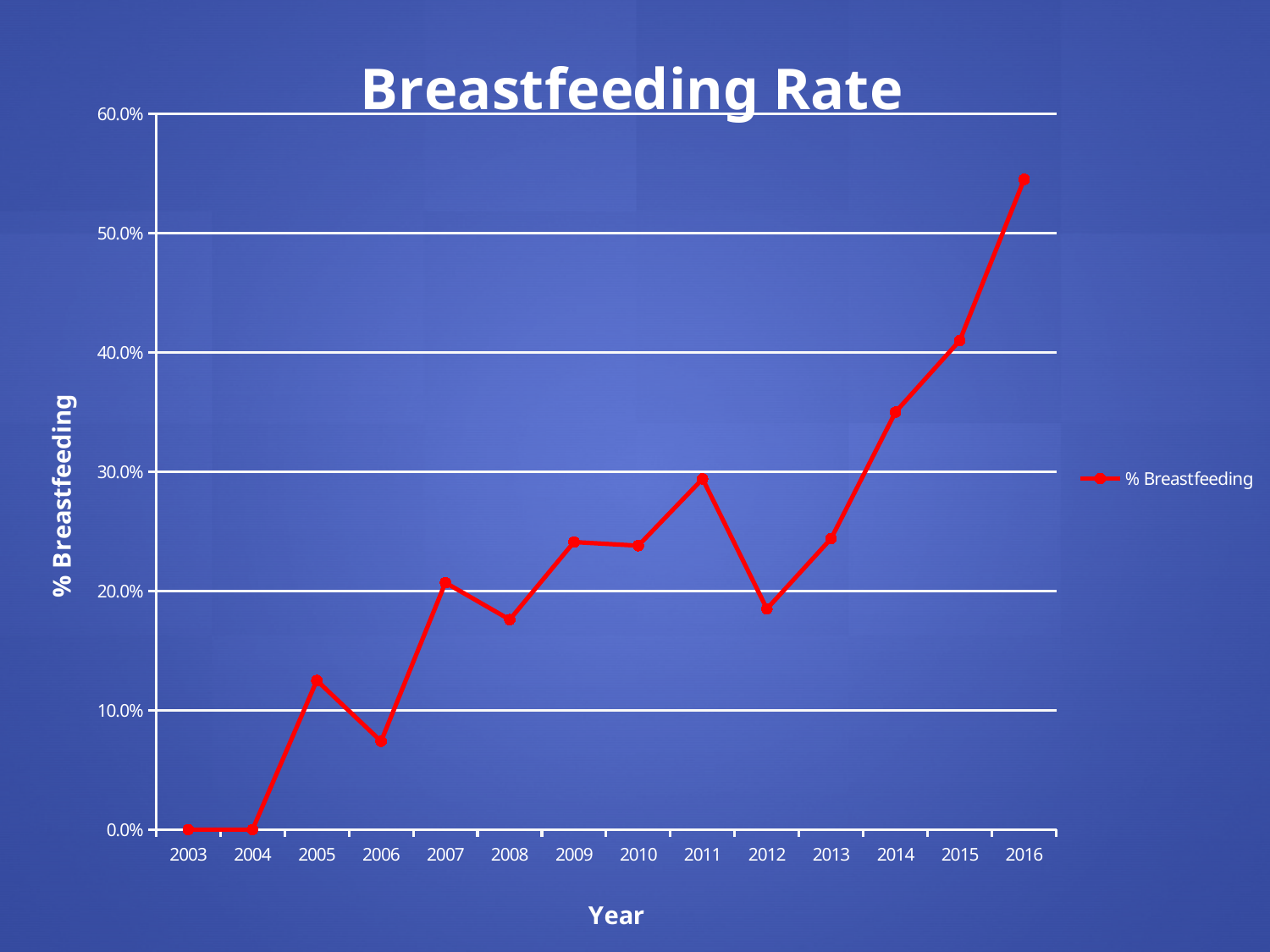
What is the title of the chart? Breastfeeding Rate What is the % Breastfeeding value for 2004? 0.0% Overall, does the % Breastfeeding value rise or fall from 2003 to 2016? rise Is the value for 2006 greater or less than 10.0%? less Is the value for 2016 greater or less than 50.0%? greater How many series does the legend list? 1 What is the % Breastfeeding value for 2003? 0.0% How many years are plotted along the x axis? 14 What type of chart is shown on the slide? line chart Which year has the highest % Breastfeeding value? 2016 Is the value for 2012 greater or less than 20.0%? less Which year has the larger % Breastfeeding value, 2012 or 2014? 2014